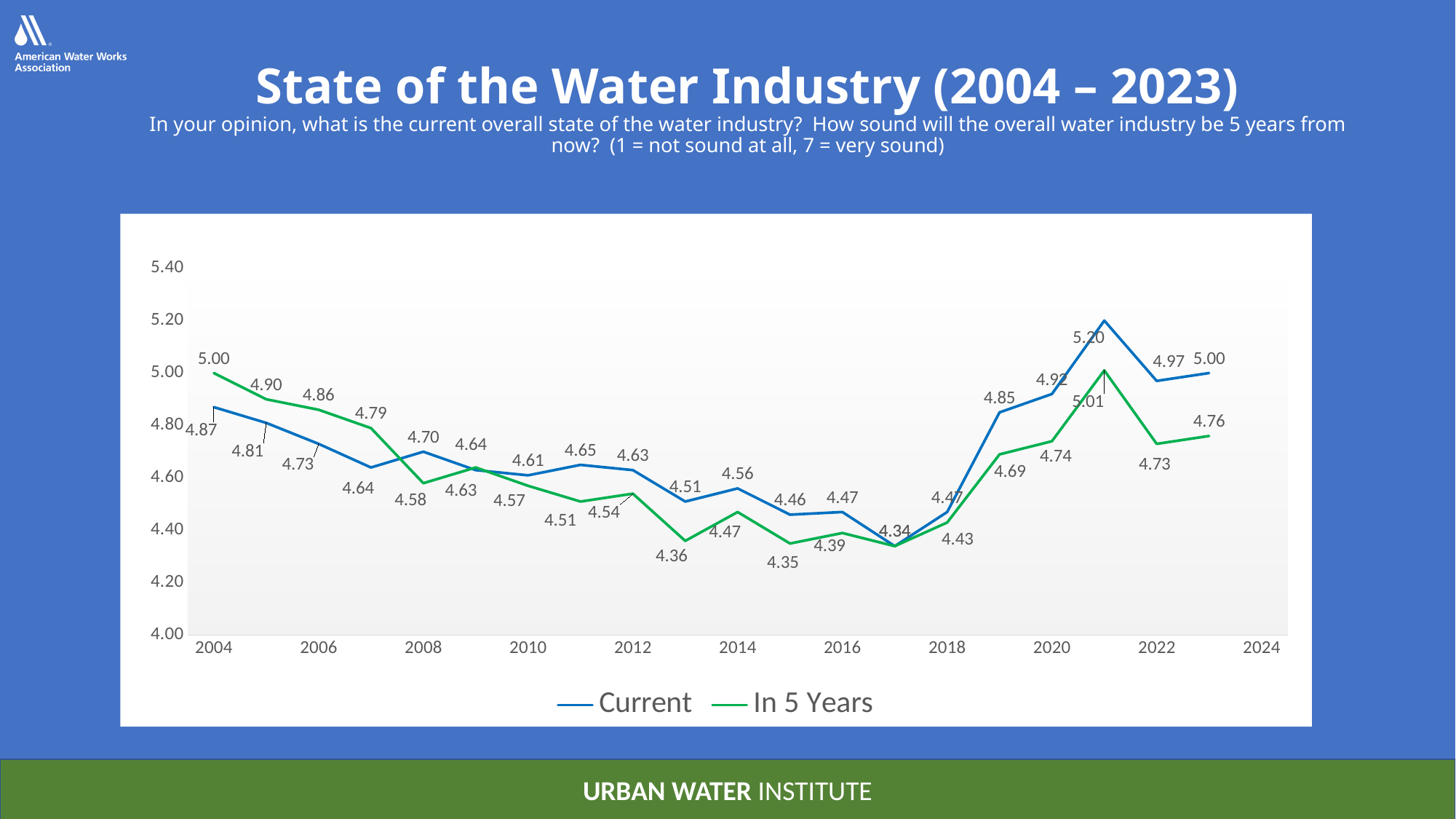
What is the In 5 Years value for 2004? 5.00 What is the difference between the Current and In 5 Years values in 2023? 0.24 In which year does the Current series reach its highest value? 2021 What is the In 5 Years value for 2023? 4.76 Does the Current series rise or fall from 2018 to 2021? rise What is the Current value for 2004? 4.87 In 2004, which series has the higher value, Current or In 5 Years? In 5 Years Is the Current value for 2021 greater or less than 5.00? greater In which year does the Current series reach its lowest value? 2017 How many series does the legend list? 2 What kind of chart is shown on the slide? line chart What is the Current value for 2021? 5.20